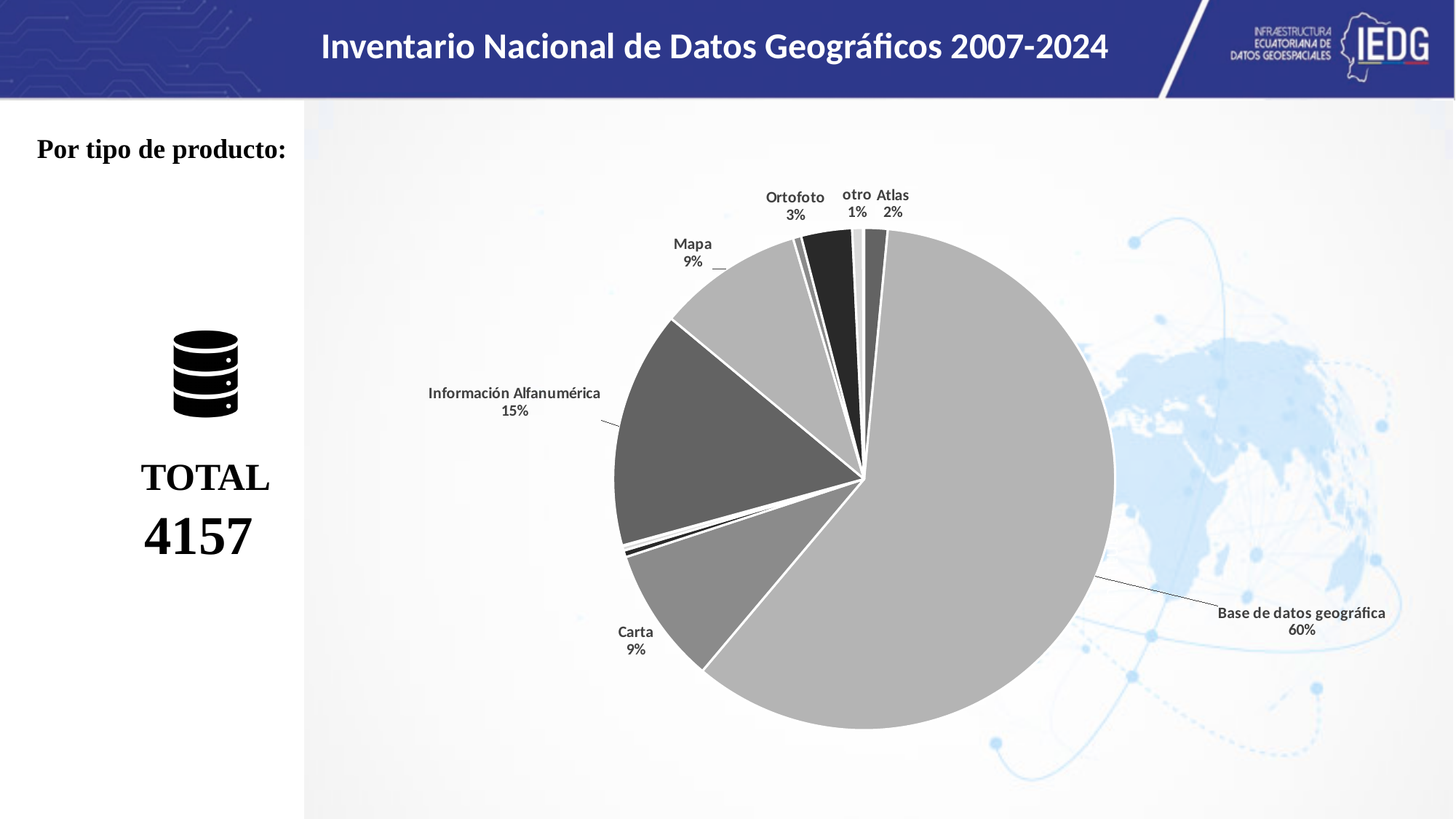
What is the difference in percentage points between Base de datos geográfica and Información Alfanumérica? 45 What percentage is shown for Ortofoto? 3% What percentage is shown for Mapa? 9% What percentage is shown for Atlas? 2% What share of the pie does Información Alfanumérica represent? 15% Which labelled category has the smallest share of the pie? otro What kind of chart is shown on the slide? pie chart What percentage is shown for otro? 1% Which is larger, the share for Ortofoto or the share for Atlas? Ortofoto Which category has the largest share of the pie? Base de datos geográfica What percentage is shown for Carta? 9% What share of the pie does Base de datos geográfica represent? 60%